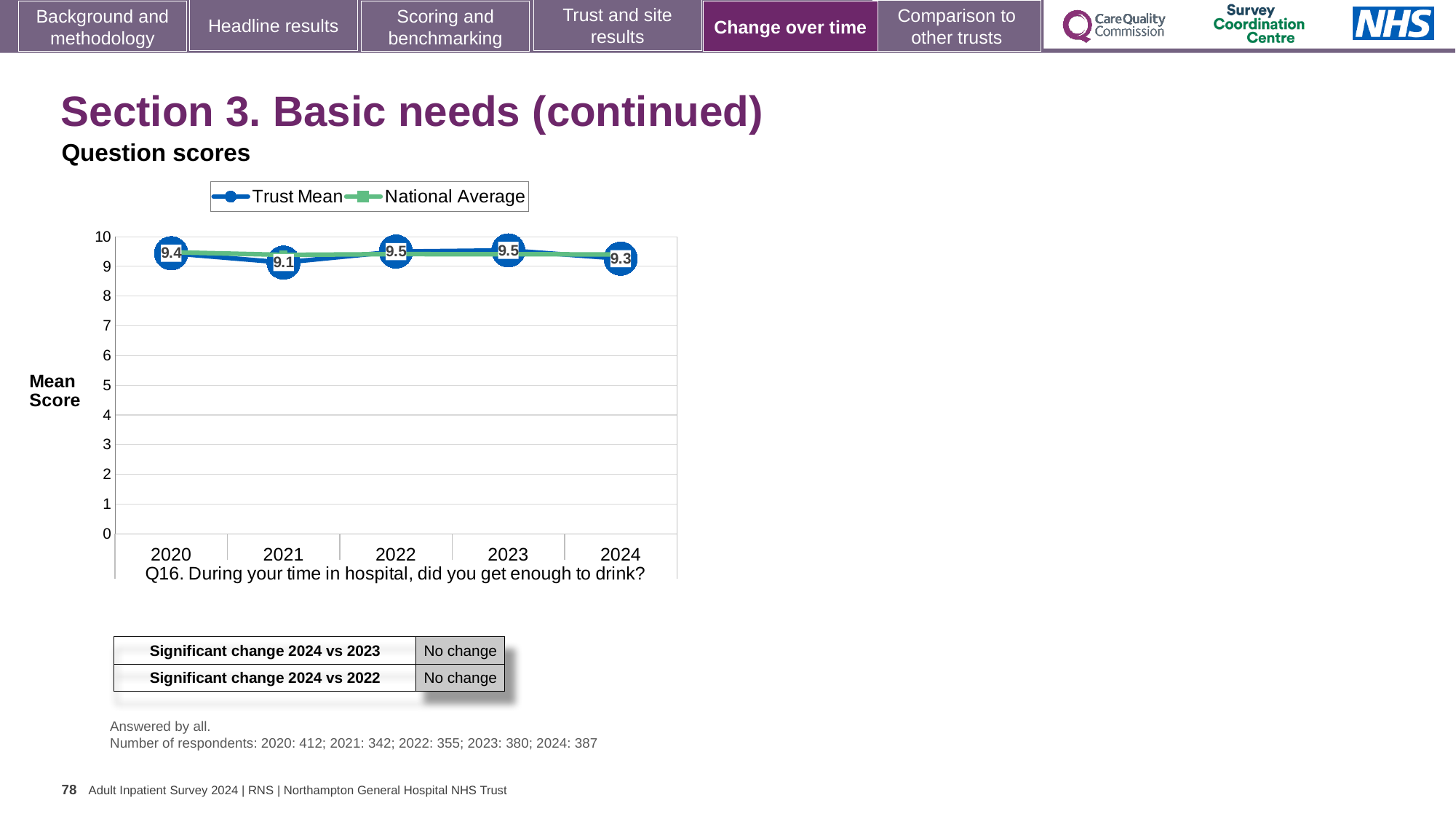
Which survey question does the chart relate to? Q16. During your time in hospital, did you get enough to drink? How many series does the legend list? 2 Is the National Average value for 2022 greater or less than 8? greater Does the Trust Mean score rise or fall from 2023 to 2024? Fall In which year is the Trust Mean score lowest? 2021 What is the Trust Mean score for 2024? 9.3 Which year has the higher Trust Mean score, 2020 or 2021? 2020 What is the Trust Mean score for 2020? 9.4 What is the difference between the Trust Mean scores for 2022 and 2021? 0.4 What is the Trust Mean score for 2021? 9.1 What kind of chart is shown on the slide? Line chart How many years are plotted on the x axis? 5